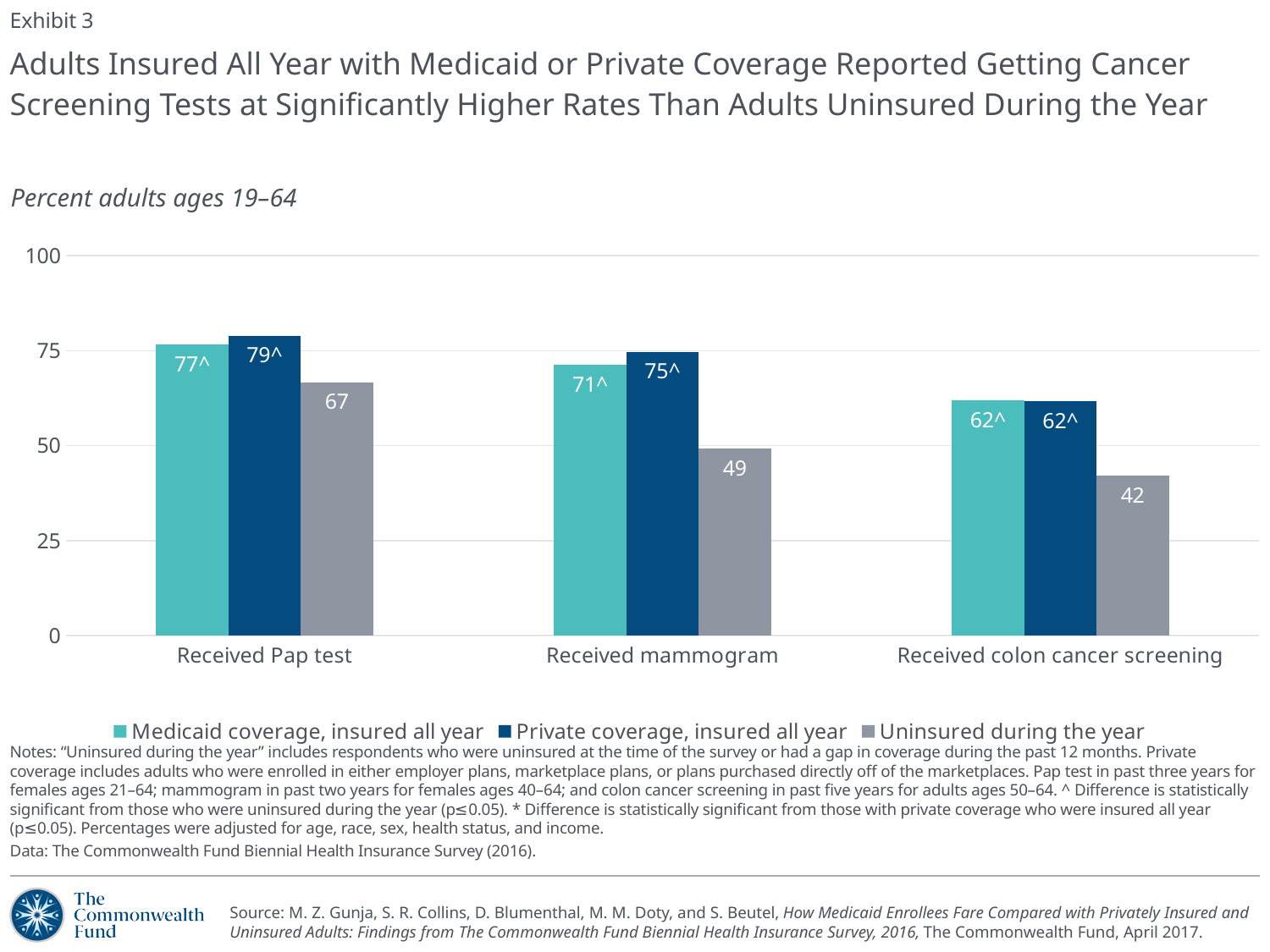
What is the subtitle describing the measure plotted on the chart? Percent adults ages 19–64 Which category has the lowest value for Private coverage, insured all year? Received colon cancer screening How many categories are shown on the x axis? 3 What is the value for Uninsured during the year for Received mammogram? 49 Which is larger for Received Pap test: the Medicaid coverage value or the Uninsured during the year value? Medicaid coverage, insured all year What is the value for Medicaid coverage, insured all year for Received Pap test? 77^ Which category has the highest value for Uninsured during the year? Received Pap test What is the value for Private coverage, insured all year for Received colon cancer screening? 62^ What kind of chart is shown on the slide? bar chart Is the value for Uninsured during the year for Received colon cancer screening greater or less than 50? less What is the difference between the Private coverage and Uninsured values for Received mammogram? 26 How many series does the legend list? 3